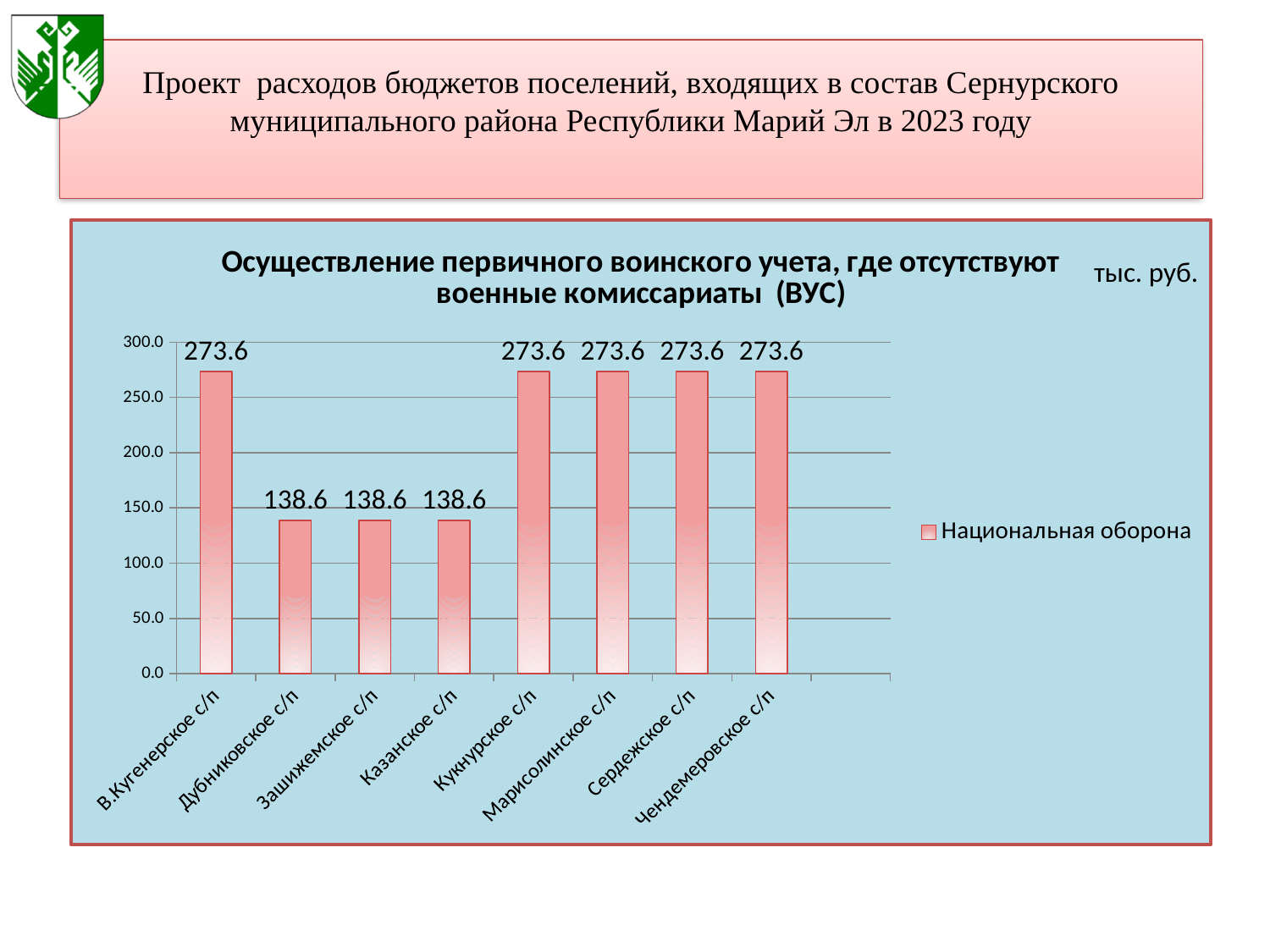
What is the value for Чендемеровское с/п? 273.6 Is the value for Сердежское с/п greater or less than 250.0? greater What is the value for Казанское с/п? 138.6 Is the value for Зашижемское с/п greater or less than 150.0? less How many series does the legend list? 1 What series name is shown in the chart legend? Национальная оборона How many categories are shown on the x axis of the chart? 8 What is the difference between the values for В.Кугенерское с/п and Зашижемское с/п? 135.0 What kind of chart is shown on the slide? bar chart Which has a larger value, Марисолинское с/п or Дубниковское с/п? Марисолинское с/п What is the value for Дубниковское с/п? 138.6 What is the value for Кукнурское с/п? 273.6